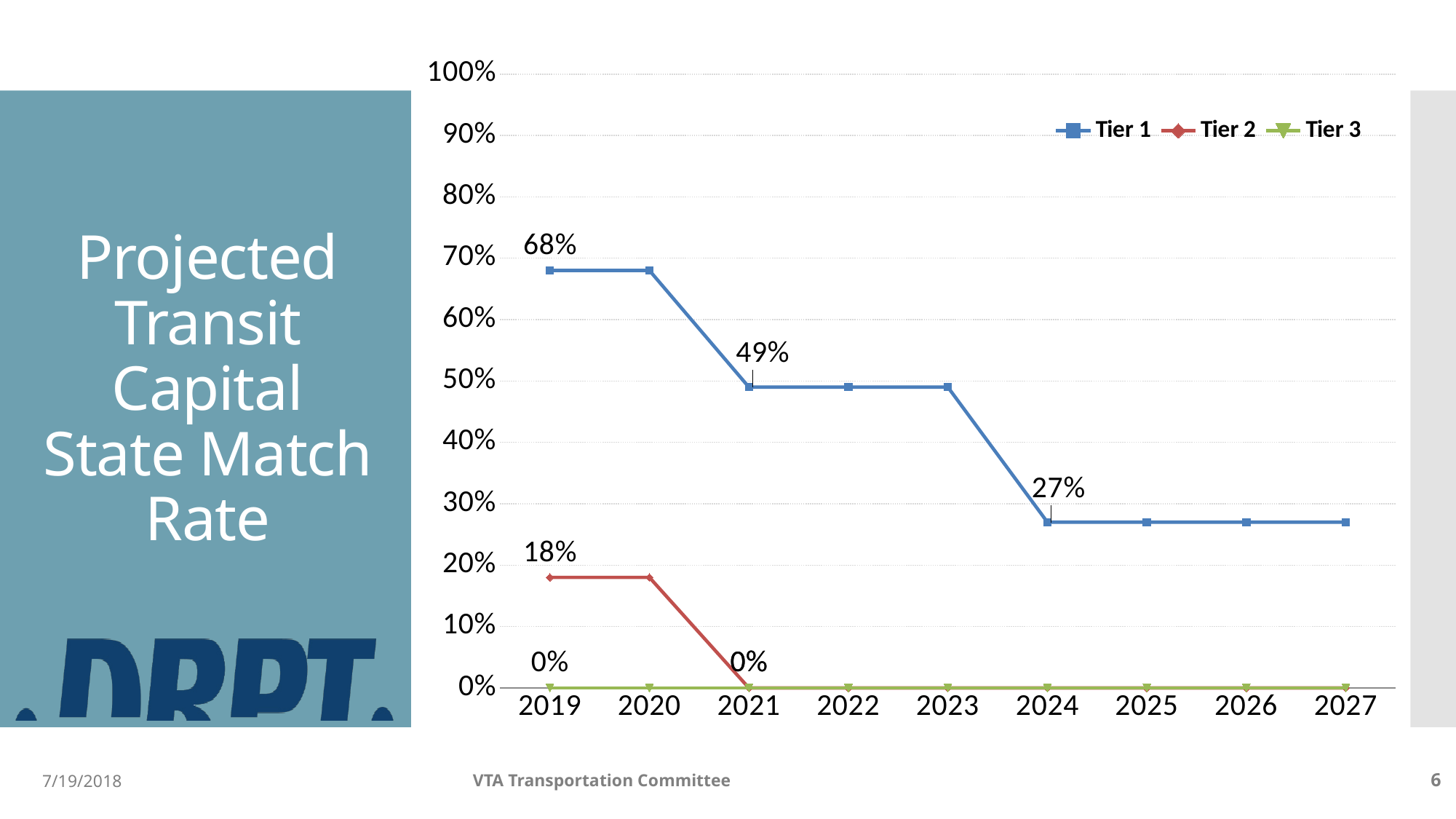
What is the Tier 1 state match rate in 2024? 27% How many years are shown on the x axis? 9 What is the Tier 2 state match rate in 2019? 18% What is the difference between the Tier 1 rate in 2019 and the Tier 1 rate in 2024? 41 percentage points Is the Tier 1 value for 2026 greater or less than 30%? less What is the Tier 1 state match rate in 2019? 68% Which tier has the highest state match rate in 2019? Tier 1 What is the Tier 2 state match rate in 2021? 0% How many series does the legend list? 3 What is the Tier 1 state match rate in 2021? 49% What kind of chart is shown on the slide? Line chart Does the Tier 1 state match rate rise or fall from 2019 to 2027? Fall